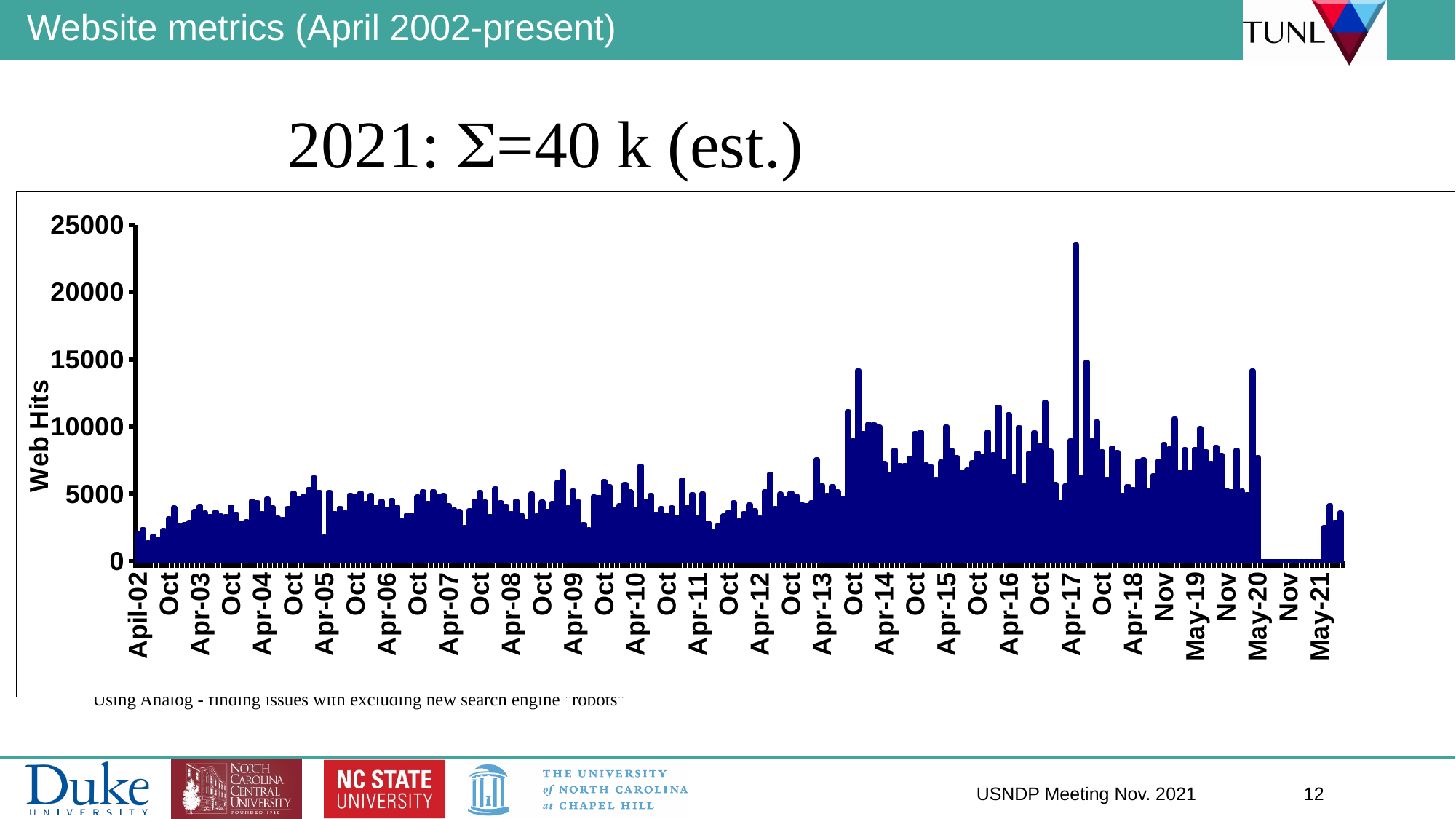
From Apr-02 to Apr-17, do the web hits generally rise or fall? rise What kind of chart is shown on the slide? bar chart Is the value for the bar at May-20 greater or less than 10000? less Is the value for the bar at Apr-05 greater or less than 10000? less Which is larger, the value at Apr-17 or the value at Apr-03? Apr-17 Is the value for the first bar (Apil-02) greater or less than 5000? less Near which x-axis label does the tallest bar in the chart occur? Apr-17 What is the label on the vertical axis of the chart? Web Hits What is the first x-axis label on the chart? Apil-02 What is the highest tick value shown on the vertical axis? 25000